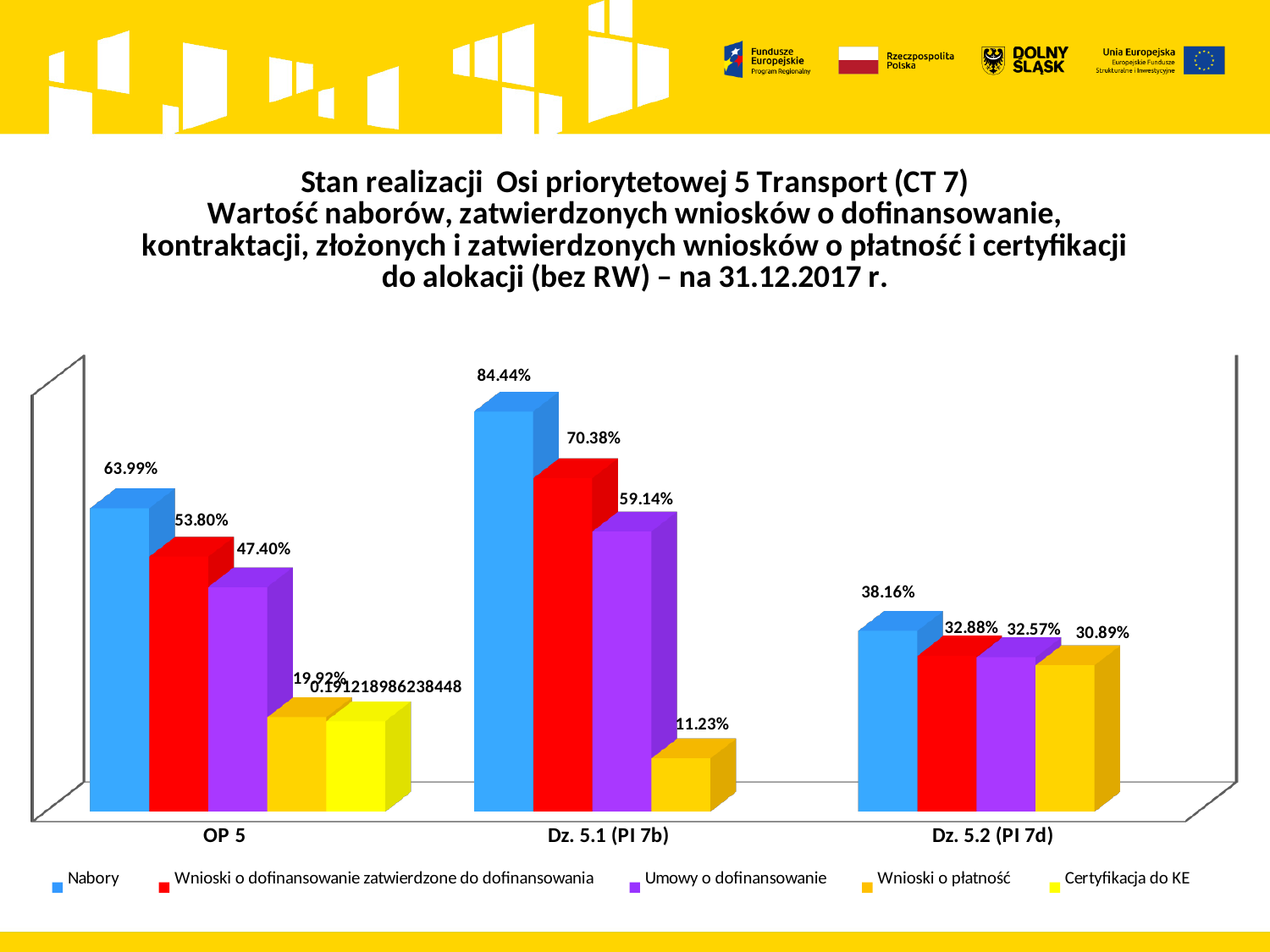
Which series is shown in red in the legend? Wnioski o dofinansowanie zatwierdzone do dofinansowania What kind of chart is shown on the slide? Bar chart What is the difference between the Nabory values for Dz. 5.1 (PI 7b) and OP 5? 20.45% Which category has the highest Nabory value? Dz. 5.1 (PI 7b) What is the value of Umowy o dofinansowanie for OP 5? 47.40% Which is larger: Wnioski o płatność for OP 5 or for Dz. 5.1 (PI 7b)? OP 5 How many series does the legend list? 5 What is the value of Wnioski o dofinansowanie zatwierdzone do dofinansowania for Dz. 5.1 (PI 7b)? 70.38% Which category has the lowest Umowy o dofinansowanie value? Dz. 5.2 (PI 7d) What is the value of Wnioski o płatność for Dz. 5.2 (PI 7d)? 30.89% What is the value of Nabory for Dz. 5.1 (PI 7b)? 84.44% How many categories are shown on the x axis? 3